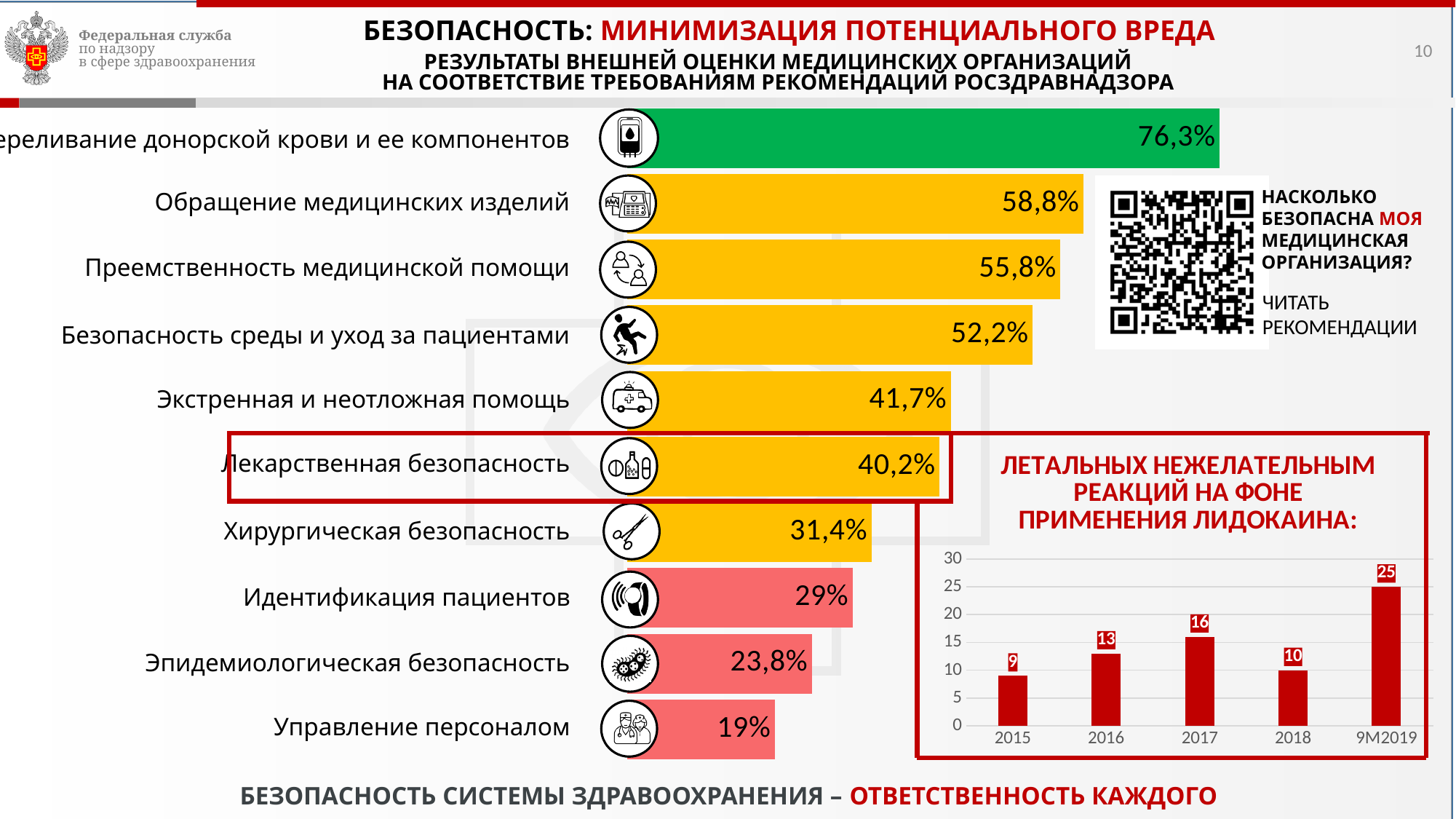
In the horizontal bar chart on the left, which is larger: Идентификация пациентов or Эпидемиологическая безопасность? Идентификация пациентов In the chart about lethal adverse reactions to lidocaine (bottom right), what is the value for 2017? 16 In the horizontal bar chart on the left, which category has the lowest value? Управление персоналом In the chart about lethal adverse reactions to lidocaine (bottom right), which year has the lowest value? 2015 In the horizontal bar chart on the left, what is the value for Безопасность среды и уход за пациентами? 52,2% In the horizontal bar chart on the left, what is the value for Лекарственная безопасность? 40,2% In the horizontal bar chart on the left, what is the value for Хирургическая безопасность? 31,4% In the chart about lethal adverse reactions to lidocaine (bottom right), what is the difference between 9М2019 and 2018? 15 How many categories are shown in the horizontal bar chart on the left? 10 In the horizontal bar chart on the left, what is the difference between Обращение медицинских изделий and Преемственность медицинской помощи? 3% What type of chart is the chart about lethal adverse reactions to lidocaine (bottom right)? Bar chart In the chart about lethal adverse reactions to lidocaine (bottom right), which period has the highest value? 9М2019